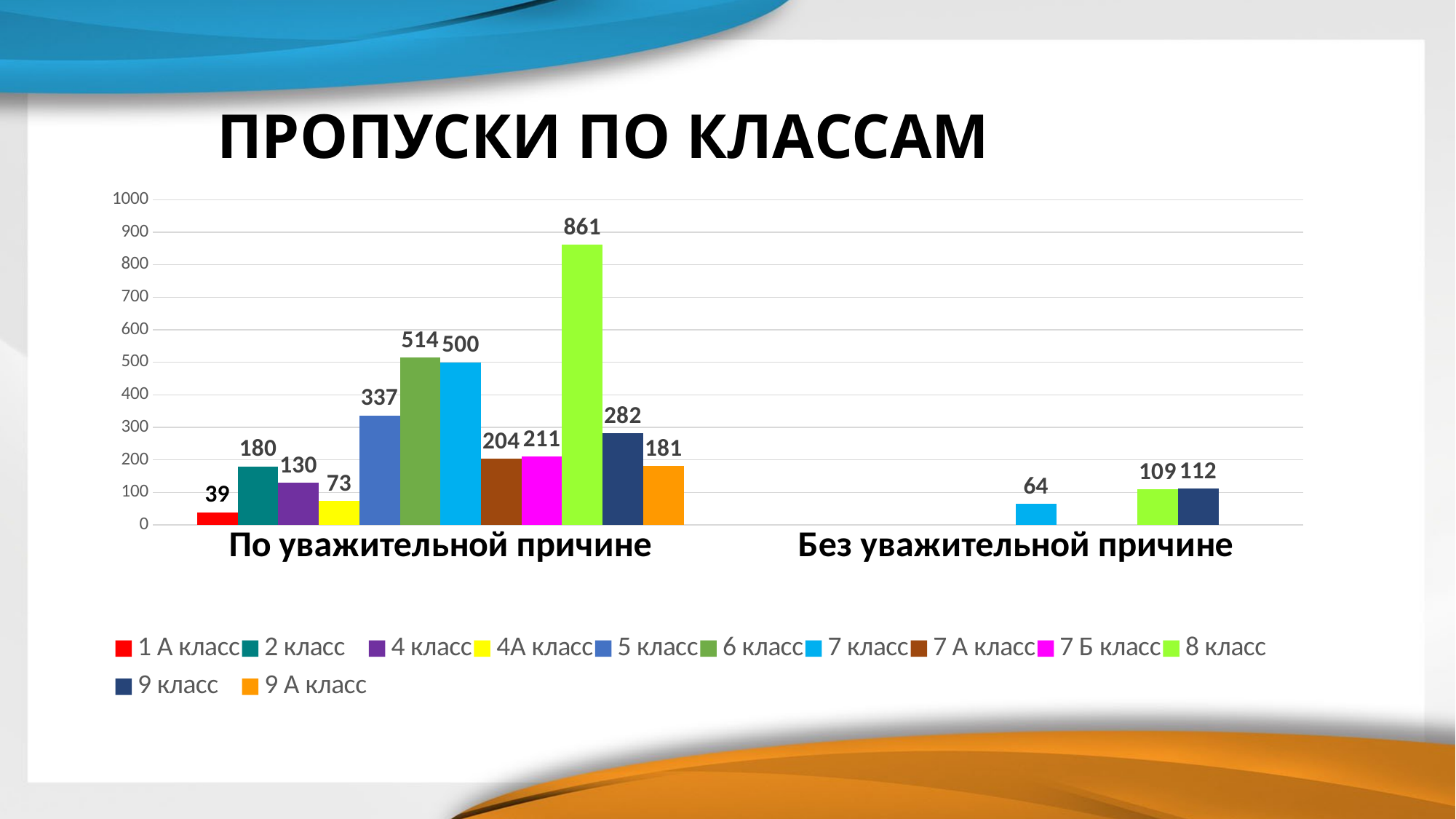
What is the title of the chart? ПРОПУСКИ ПО КЛАССАМ Which class has the highest value in the category 'По уважительной причине'? 8 класс What is the value for 8 класс in the category 'По уважительной причине'? 861 What type of chart is shown on the slide? bar chart How many categories are shown on the x axis? 2 Which is larger in the category 'По уважительной причине': the value for 2 класс or the value for 4 класс? 2 класс What is the value for 9 класс in the category 'Без уважительной причине'? 112 What is the difference between the values for 6 класс and 7 класс in the category 'По уважительной причине'? 14 How many series does the legend list? 12 Which class has the lowest value in the category 'По уважительной причине'? 1 А класс What is the value for 7 класс in the category 'Без уважительной причине'? 64 What is the value for 5 класс in the category 'По уважительной причине'? 337